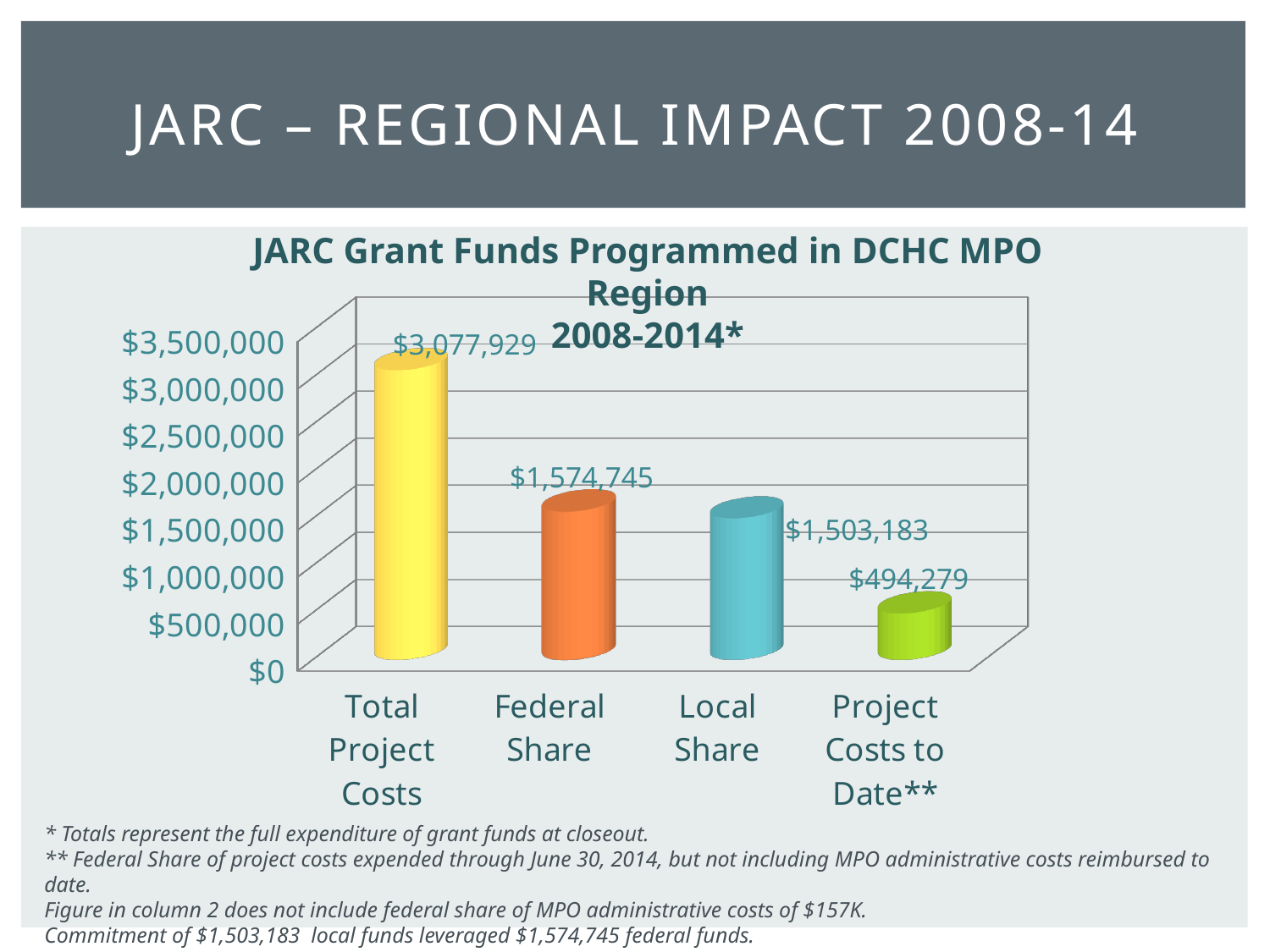
What is the value for Federal Share? $1,574,745 What is the value for Project Costs to Date**? $494,279 Which category has the highest value? Total Project Costs How many categories are shown in the chart? 4 Which is larger, Federal Share or Local Share? Federal Share What is the difference between Federal Share and Local Share? $71,562 Which category has the lowest value? Project Costs to Date** What kind of chart is shown on the slide? Bar chart What is the difference between Total Project Costs and Project Costs to Date**? $2,583,650 What is the value for Total Project Costs? $3,077,929 What is the value for Local Share? $1,503,183 What is the title of the chart? JARC Grant Funds Programmed in DCHC MPO Region 2008-2014*